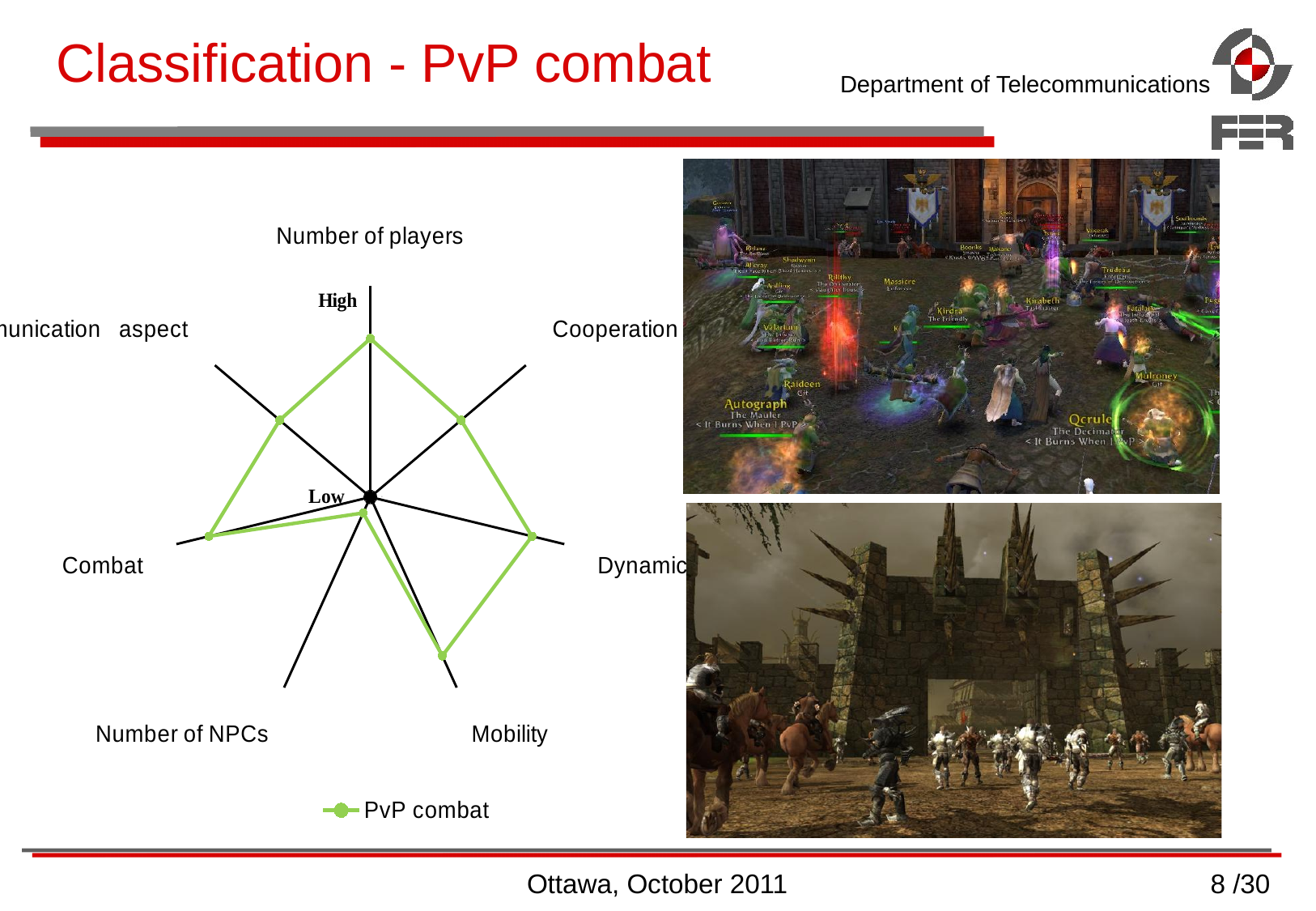
What kind of chart is shown on the slide? Radar chart What is the name of the series shown in the chart's legend? PvP combat Which category has the lowest value for PvP combat? Number of NPCs Which is larger for PvP combat, Number of players or Number of NPCs? Number of players How many series does the chart's legend list? 1 Which is larger for PvP combat, Mobility or Number of NPCs? Mobility Which is larger for PvP combat, Combat or Cooperation? Combat How many axes (categories) does the radar chart have? 7 What are the two scale labels printed along the vertical axis of the radar chart? High and Low